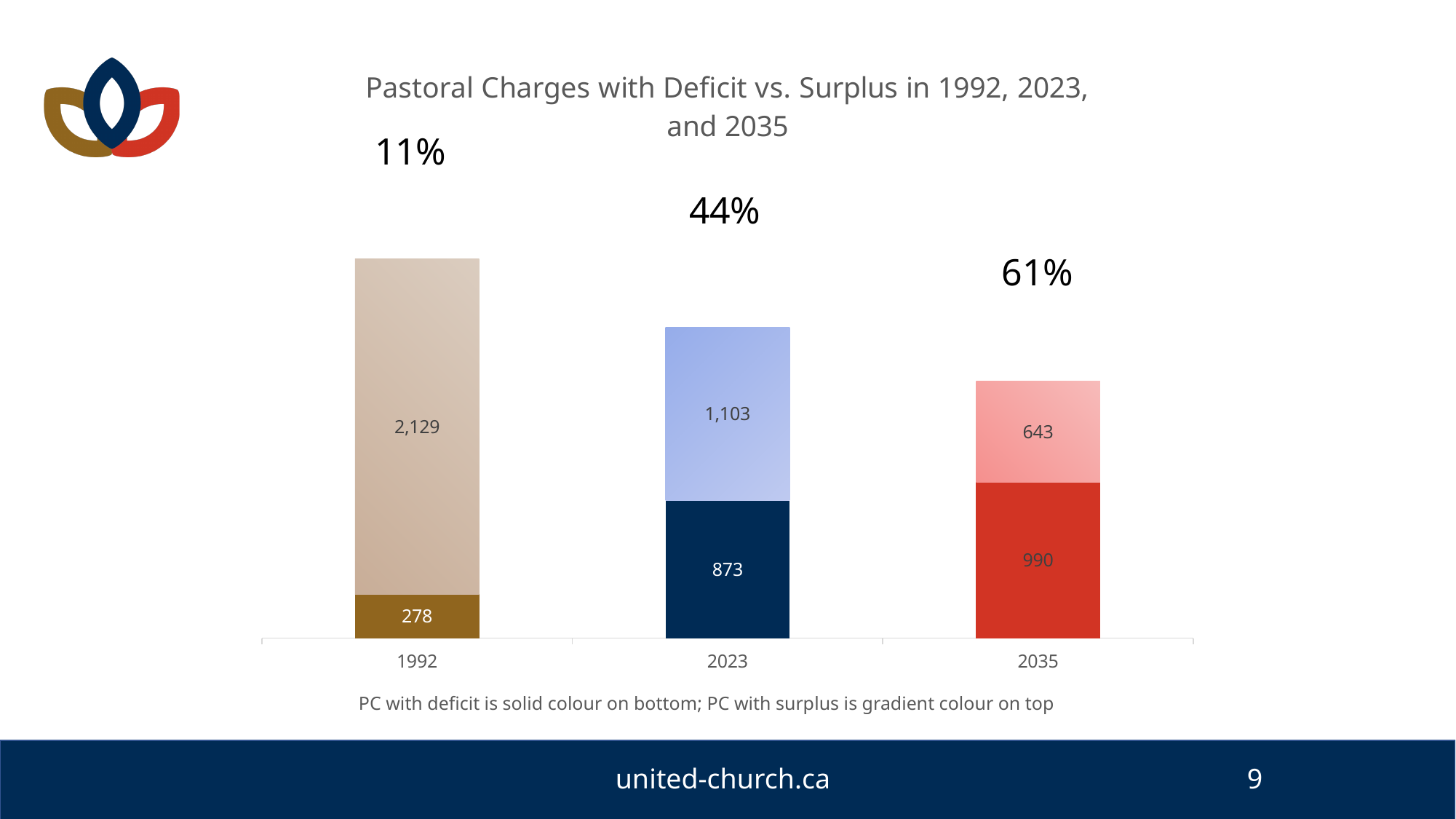
Is the deficit value for 2035 larger or smaller than the surplus value for 2035? larger Do the deficit values rise or fall from 1992 to 2035? rise Which year has the highest number of pastoral charges with a surplus? 1992 How many years are shown on the x axis of the chart? 3 Which year has the lowest number of pastoral charges with a deficit? 1992 What is the number of pastoral charges with a deficit in 2035? 990 What percentage is shown above the 2023 bar? 44% What is the number of pastoral charges with a surplus in 2023? 1,103 What is the total of the stacked bar for 2023? 1,976 What is the difference between the surplus value in 1992 and the surplus value in 2035? 1,486 What type of chart is shown on the slide? stacked bar chart What is the number of pastoral charges with a deficit in 1992? 278